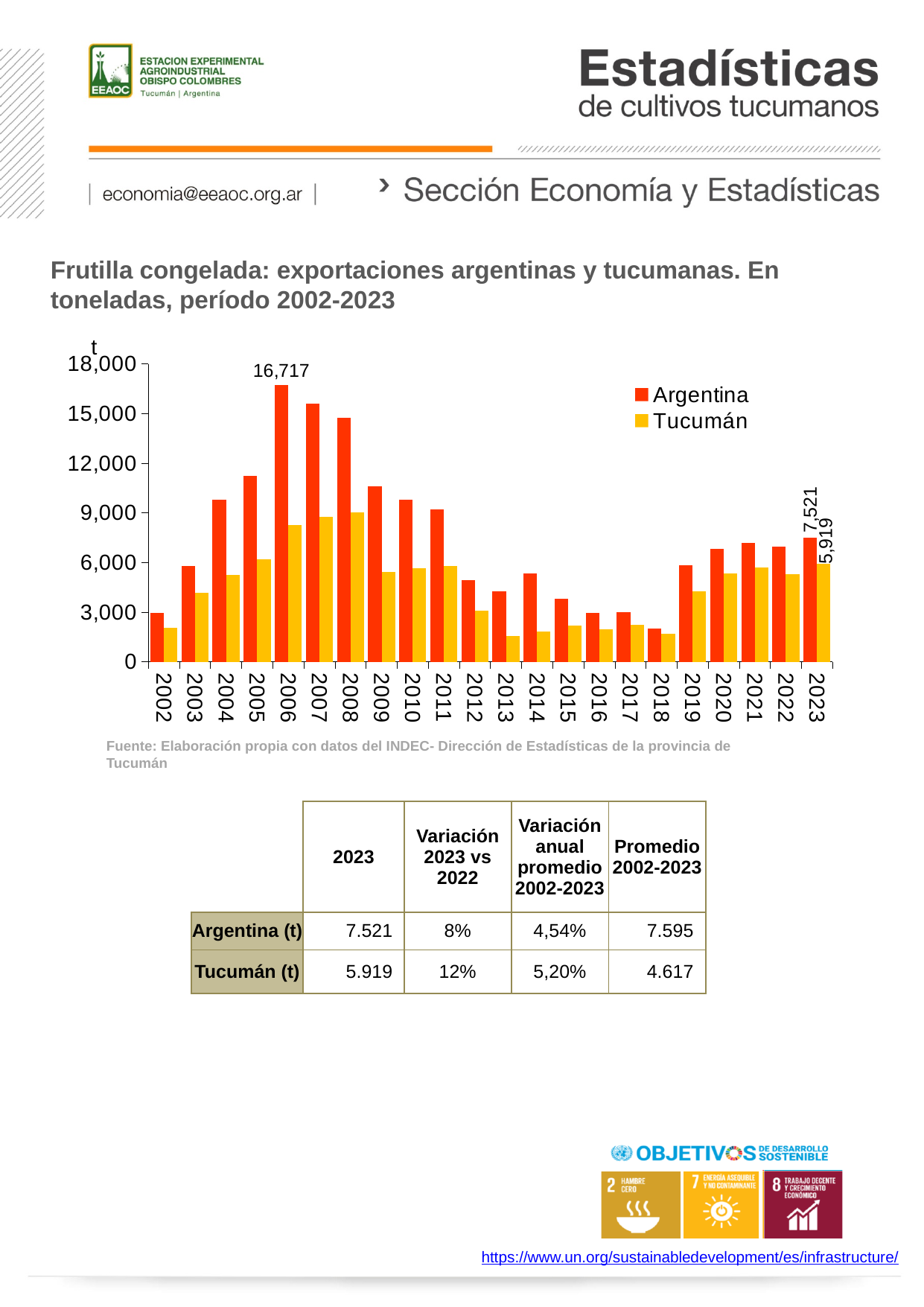
Is the value for Argentina in 2007 greater or less than 15,000? greater Which year had the larger Argentina value, 2008 or 2009? 2008 Is the value for Tucumán in 2006 greater or less than 9,000? less What was the value for Argentina in 2006? 16,717 How many series does the legend list? 2 What was the value for Argentina in 2023? 7,521 What kind of chart is shown on the slide? bar chart How many years are shown on the x axis? 22 What was the value for Tucumán in 2023? 5,919 In which year did Argentina have its lowest value? 2018 In which year did Argentina reach its highest value? 2006 In 2023, how much larger was the Argentina value than the Tucumán value? 1,602